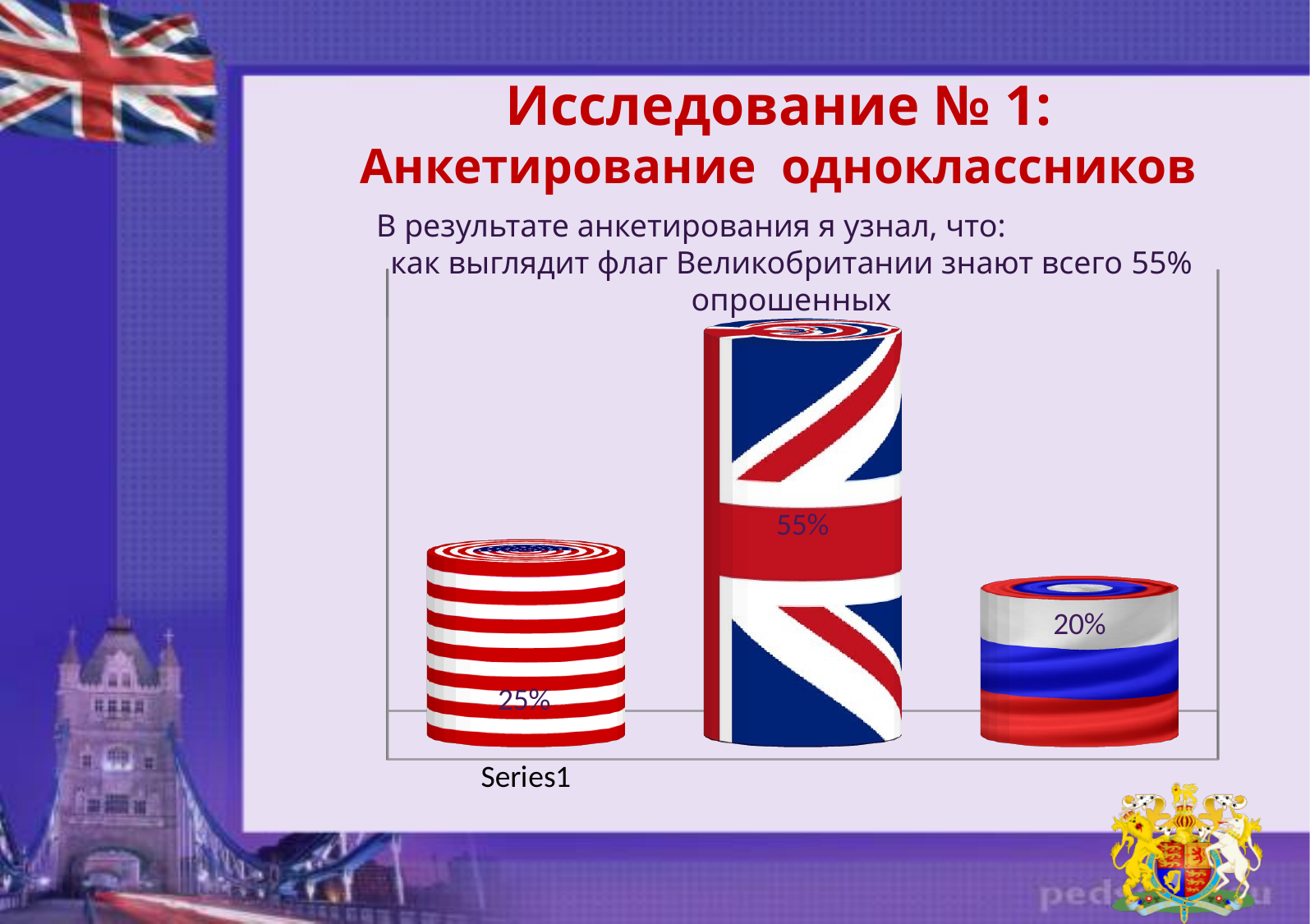
Which bar is the tallest in the chart? The middle bar (UK flag), 55% What value is printed on the middle bar, the one patterned with the UK flag? 55% What label is printed below the chart on the x axis? Series1 What value is printed on the left bar, the one patterned with the US flag? 25% What kind of chart is shown on the slide? Bar chart Which is larger: the value on the left bar (US flag) or the value on the right bar (Russian flag)? The left bar (25%) What is the difference between the value on the middle bar (55%) and the value on the left bar (25%)? 30 percentage points Which bar is the shortest in the chart? The right bar (Russian flag), 20% What is the difference between the value on the left bar (25%) and the value on the right bar (20%)? 5 percentage points What is the difference between the value on the middle bar (55%) and the value on the right bar (20%)? 35 percentage points What value is printed on the right bar, the one patterned with the Russian flag? 20% How many bars are plotted in the chart? 3